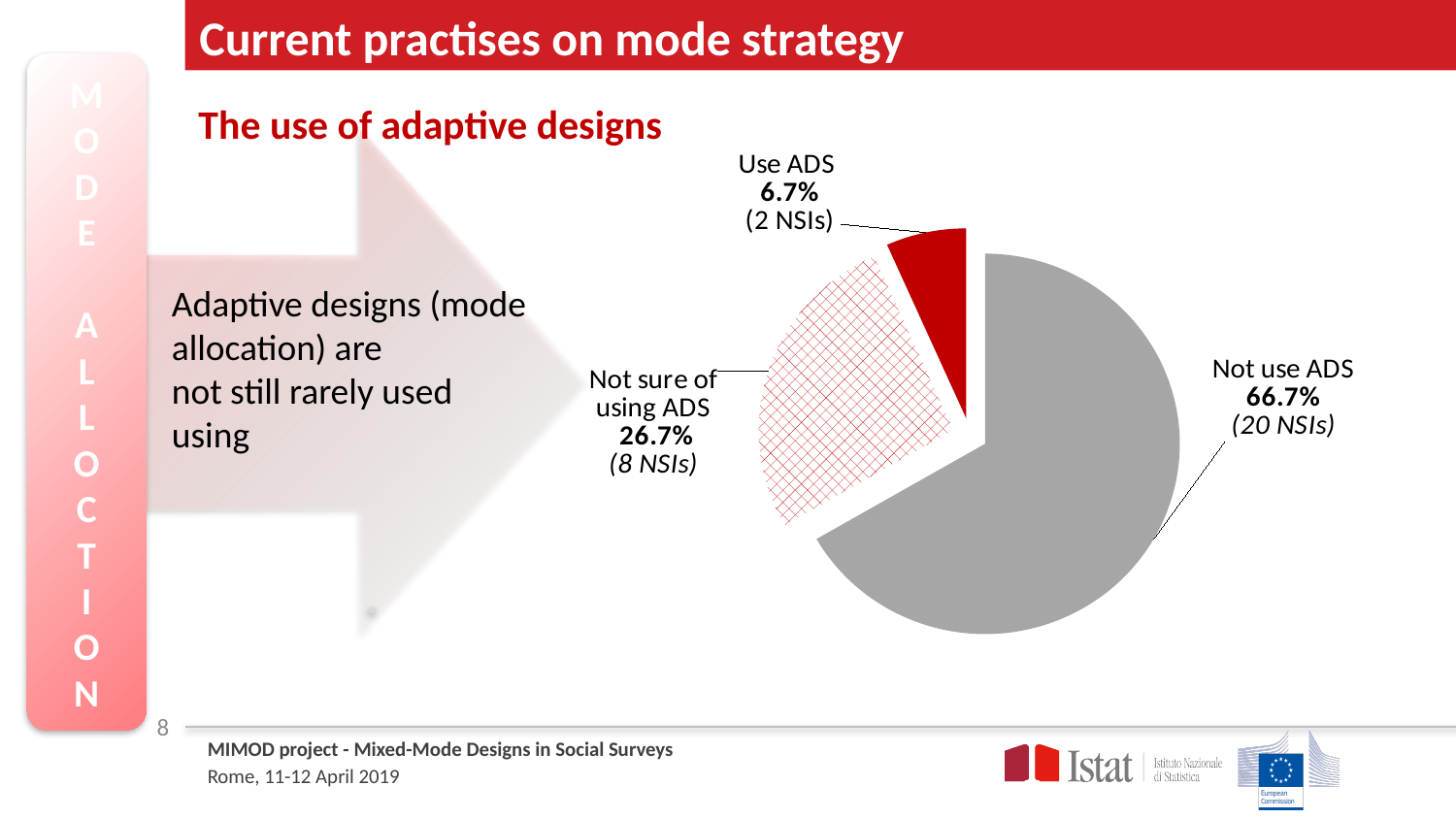
Which slice of the pie is shown with a cross-hatched pattern? Not sure of using ADS How many slices does the pie chart have? 3 What percentage of NSIs do not use ADS? 66.7% Which category has the largest share of the pie? Not use ADS How many NSIs do not use ADS? 20 NSIs What type of chart is shown on the slide? Pie chart What is the difference in percentage points between 'Not use ADS' and 'Not sure of using ADS'? 40 percentage points What percentage of NSIs are not sure of using ADS? 26.7% What percentage of NSIs use ADS? 6.7% Which category has the smallest share of the pie? Use ADS Which is larger: the share for 'Not sure of using ADS' or the share for 'Use ADS'? Not sure of using ADS How many NSIs are not sure of using ADS? 8 NSIs